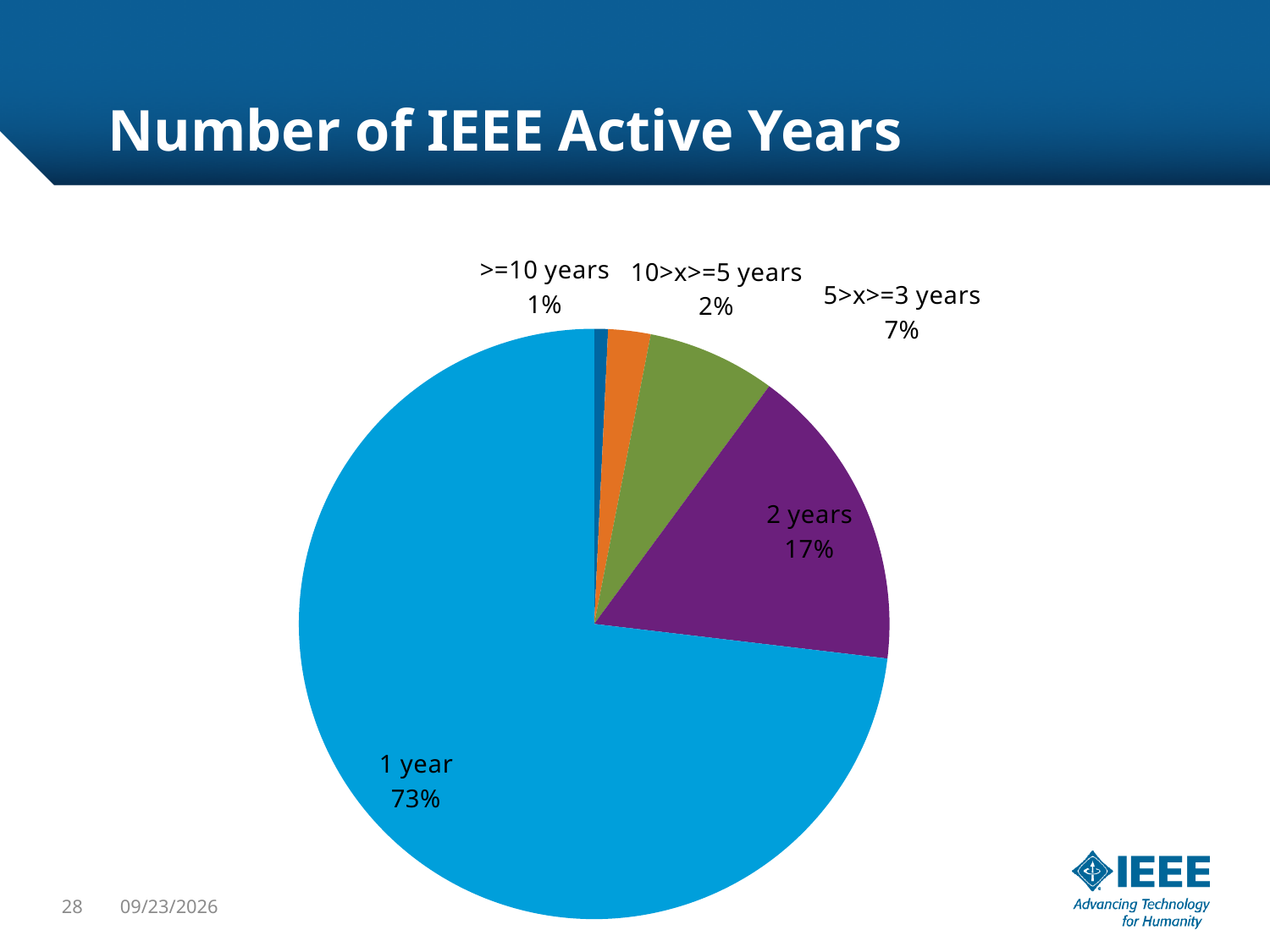
Which slice is larger, "5>x>=3 years" or "10>x>=5 years"? 5>x>=3 years What percentage is shown for the "5>x>=3 years" slice? 7% How many slices does the pie chart have? 5 What percentage of the pie is the "2 years" slice? 17% What is the difference in percentage points between the "1 year" slice and the "2 years" slice? 56 What kind of chart is shown on the slide? Pie chart What is the title of the chart? Number of IEEE Active Years Which category has the smallest share of the pie? >=10 years What percentage of the pie is the "1 year" slice? 73% What percentage is shown for the ">=10 years" slice? 1% What percentage is shown for the "10>x>=5 years" slice? 2% Which category has the largest share of the pie? 1 year